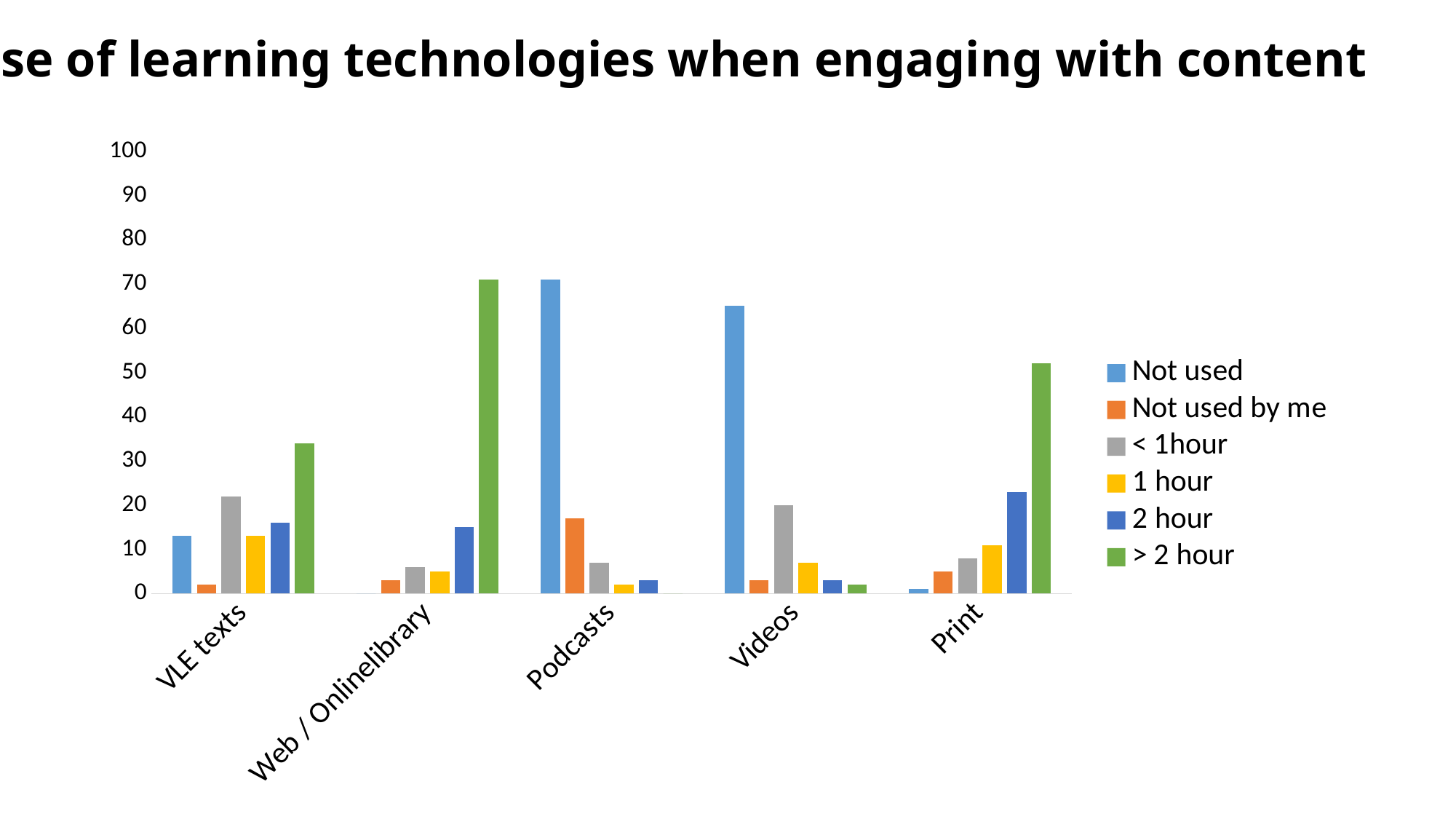
How many series does the legend list? 6 For VLE texts, which is larger: the "< 1hour" bar or the "1 hour" bar? < 1hour Is the "Not used" value for Videos greater or less than 50? greater Is the "2 hour" value for Print greater or less than 10? greater Is the "> 2 hour" value for Print greater or less than 40? greater How many learning technology categories are shown on the x axis? 5 What kind of chart is shown on the slide? bar chart Which category has the highest "> 2 hour" bar? Web / Onlinelibrary Which category has the highest "Not used" bar? Podcasts What colour represents the "> 2 hour" series in the legend? green